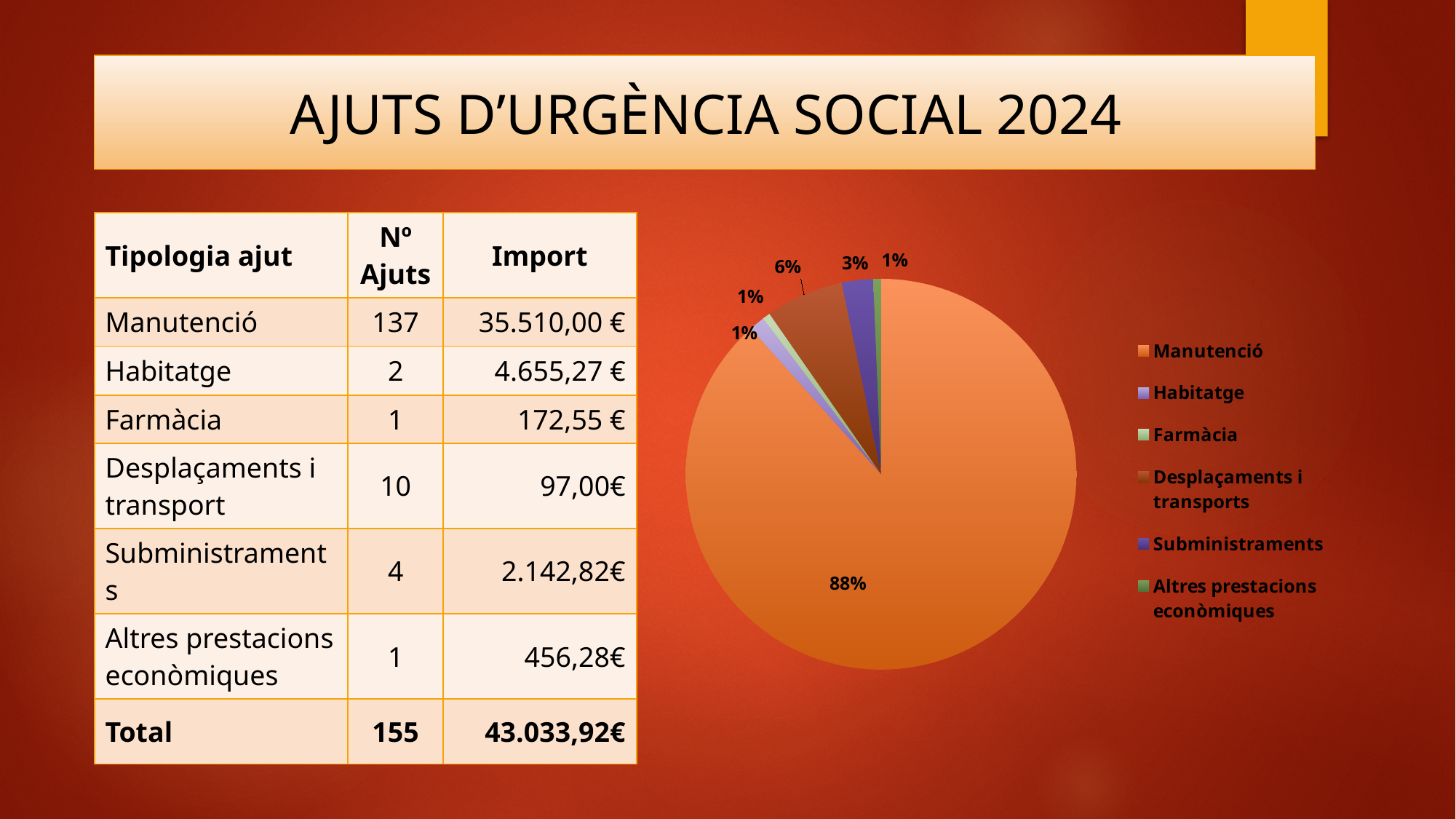
What percentage of the pie chart does Habitatge represent? 1% Which category has the largest slice in the pie chart? Manutenció What percentage of the pie chart does Manutenció represent? 88% What colour is the Manutenció slice in the pie chart? orange How many entries does the pie chart's legend list? 6 Which slice is larger in the pie chart, Desplaçaments i transports or Subministraments? Desplaçaments i transports What type of chart is shown on the slide? pie chart What percentage of the pie chart does Subministraments represent? 3% How many slices does the pie chart have? 6 What is the difference in percentage points between the Manutenció slice and the Desplaçaments i transports slice? 82% Where is the legend positioned relative to the pie chart? to the right